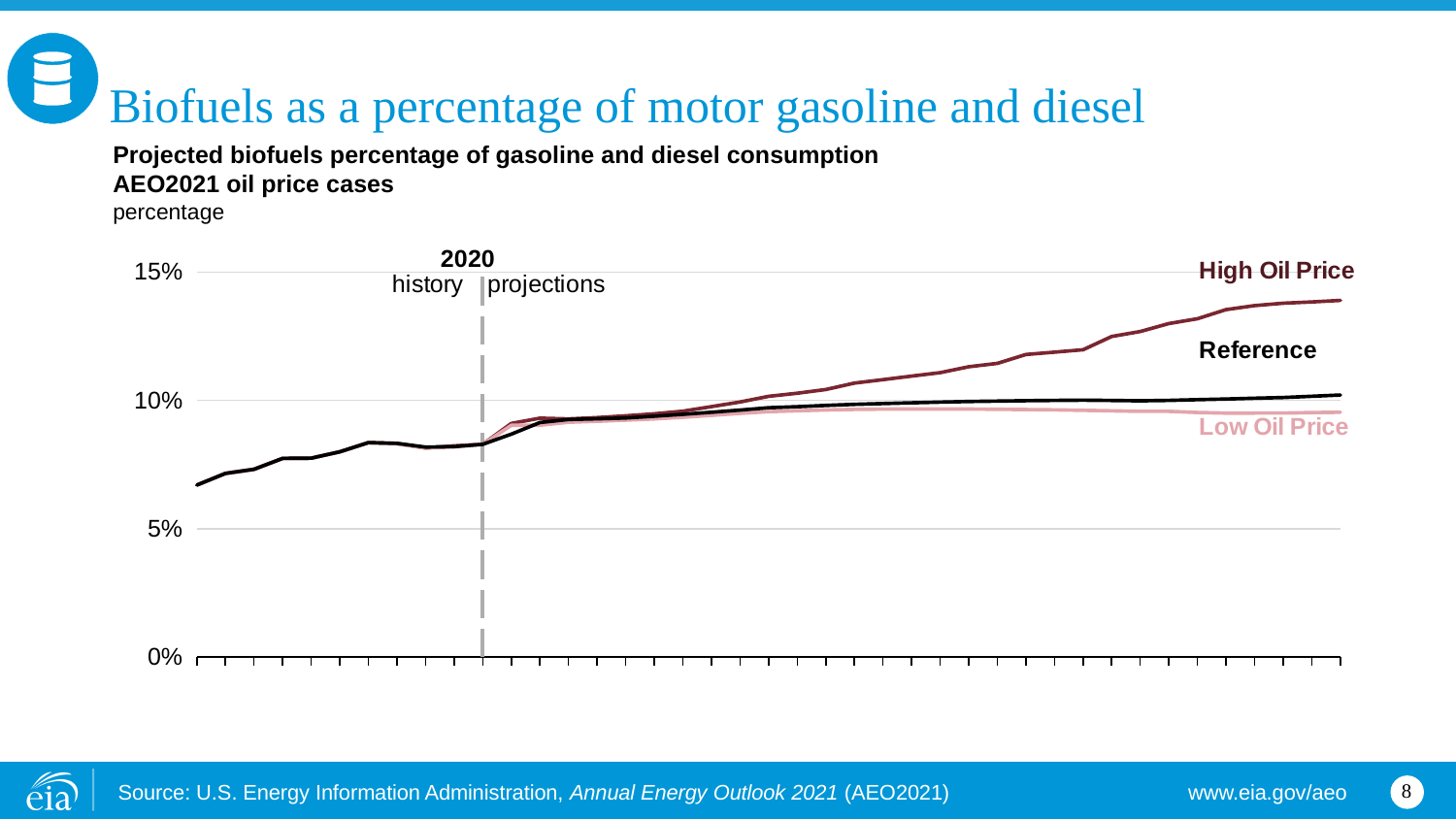
Is the value for Low Oil Price at the end of the projection period greater or less than 10%? less Is the value at the start of the history period greater or less than 5%? greater Which series has the highest value at the end of the projection period? High Oil Price Is the value for High Oil Price at the end of the projection period greater or less than 10%? greater Which series has the lowest value at the end of the projection period? Low Oil Price What kind of chart is shown on the slide? line chart What year does the dashed vertical line separating history from projections mark? 2020 How many series are labelled on the chart? 3 What is the title of the chart? Projected biofuels percentage of gasoline and diesel consumption AEO2021 oil price cases Does the High Oil Price series rise or fall over the projection period? rise At the end of the projection period, which is larger: the High Oil Price value or the Low Oil Price value? High Oil Price